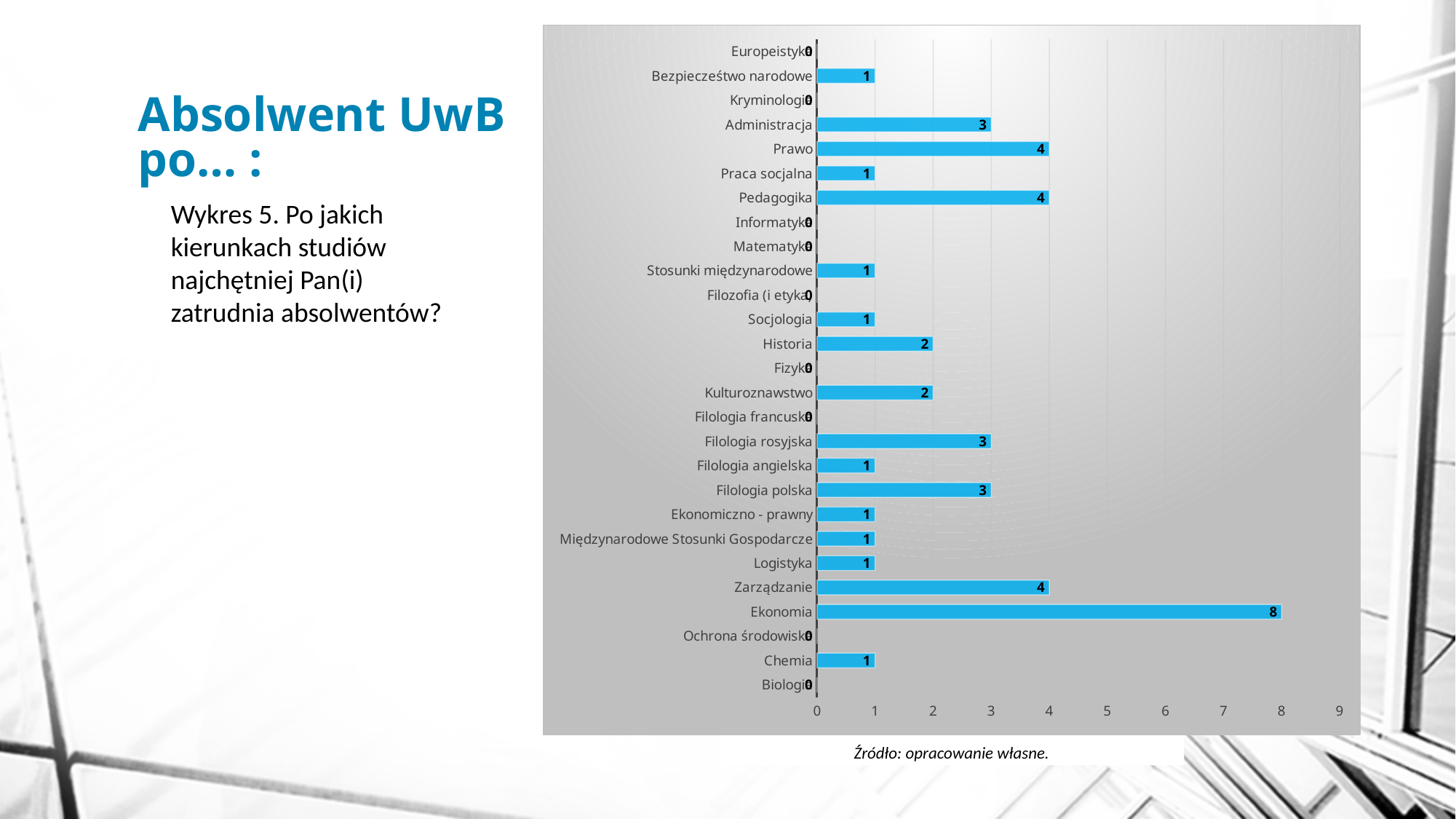
What is the value for Pedagogika? 4 What is the value for Historia? 2 Which category has the highest value in the chart? Ekonomia What is the caption of the chart given on the slide? Wykres 5. Po jakich kierunkach studiów najchętniej Pan(i) zatrudnia absolwentów? What is the value for Administracja? 3 What is the value for Ekonomia? 8 How many categories have a value of 0? 9 What is the value for Kryminologia? 0 How many categories are shown in the chart? 27 What is the difference between the values for Ekonomia and Zarządzanie? 4 What type of chart is shown on the slide? bar chart Which is larger, the value for Prawo or the value for Filologia rosyjska? Prawo